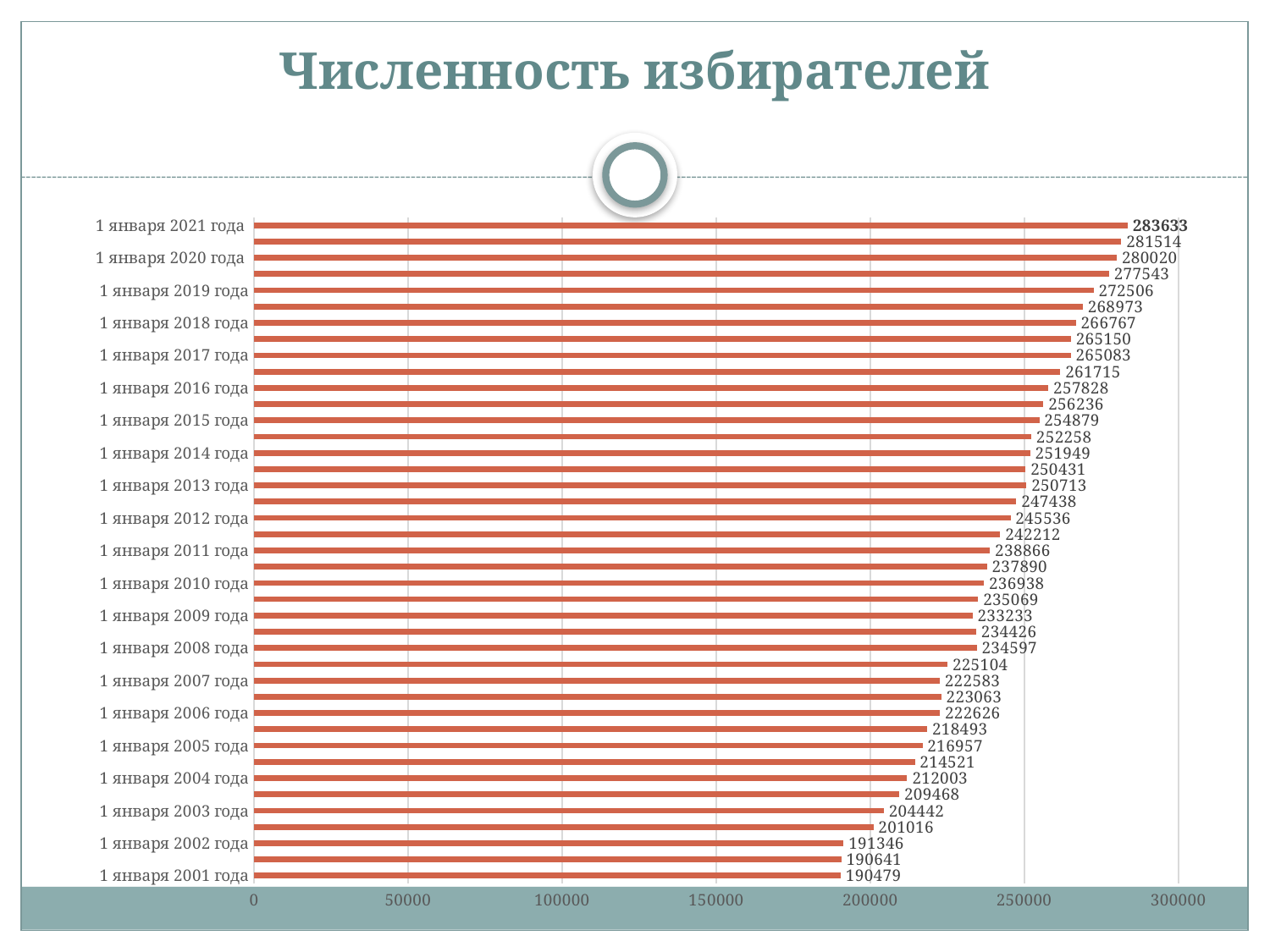
Which is larger, the value for 1 января 2019 года or for 1 января 2018 года? 1 января 2019 года What value is shown for 1 января 2010 года? 236938 What value is shown for 1 января 2015 года? 254879 What is the title of the chart? Численность избирателей Which labeled date has the lowest number of voters? 1 января 2001 года By how much does the value for 1 января 2021 года exceed the value for 1 января 2001 года? 93154 What is the number of voters on 1 января 2001 года? 190479 What is the number of voters on 1 января 2021 года? 283633 What kind of chart is shown on the slide? bar chart Which labeled date has the highest number of voters? 1 января 2021 года Is the value for 1 января 2005 года greater or less than 200000? greater What is the difference between the values for 1 января 2020 года and 1 января 2019 года? 7514